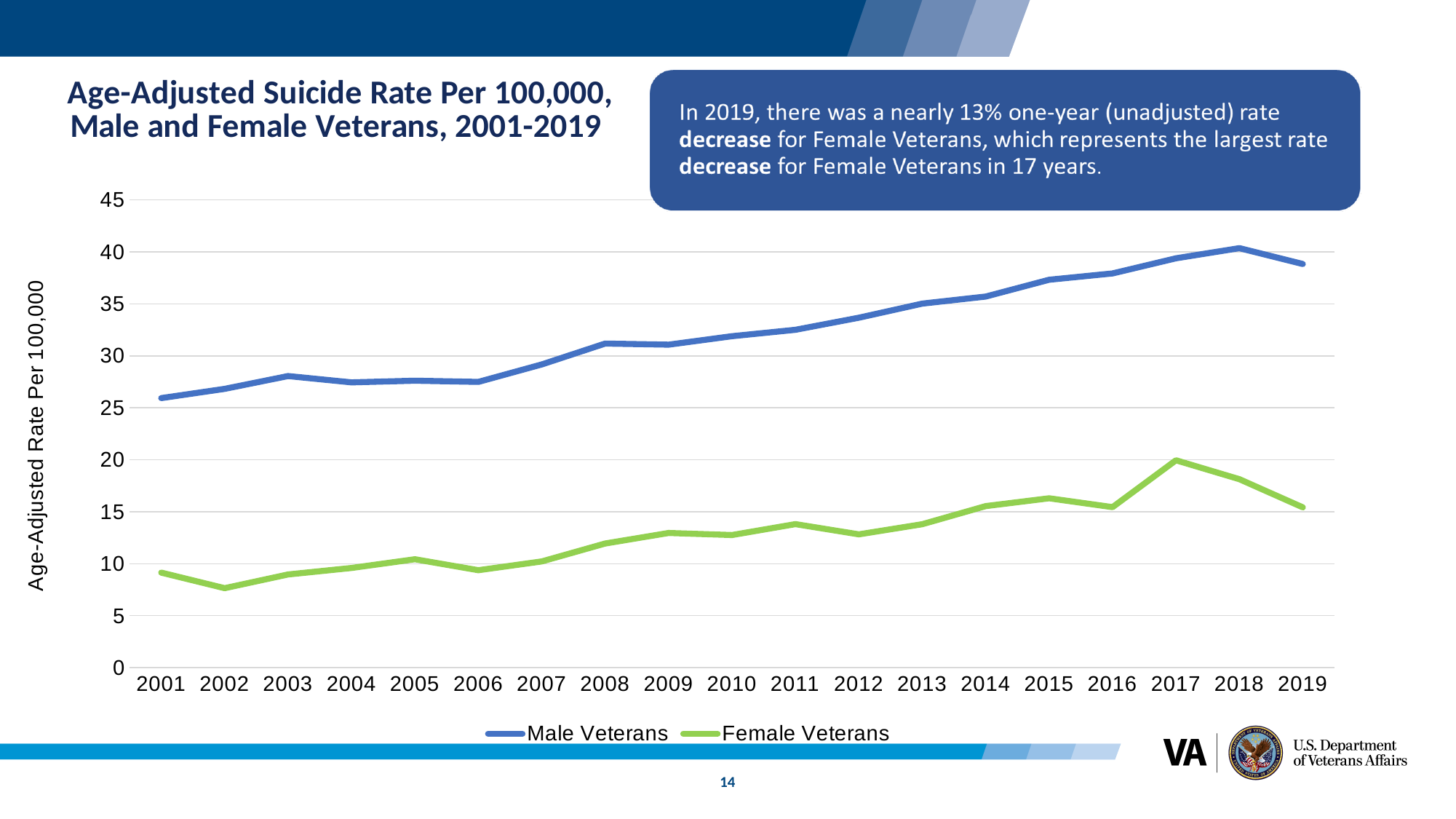
In which year does the Male Veterans line reach its highest value? 2018 How many years are plotted along the x axis? 19 In which year does the Female Veterans line reach its lowest value? 2002 What is the label of the y axis? Age-Adjusted Rate Per 100,000 Is the value for Male Veterans in 2019 greater or less than 40? less Is the value for Male Veterans in 2008 greater or less than 30? greater What kind of chart is shown on the slide? Line chart How many series does the legend list? 2 In which year does the Female Veterans line reach its highest value? 2017 In which year does the Male Veterans line reach its lowest value? 2001 Is the value for Female Veterans in 2002 greater or less than 10? less Which series has the higher value in 2010, Male Veterans or Female Veterans? Male Veterans